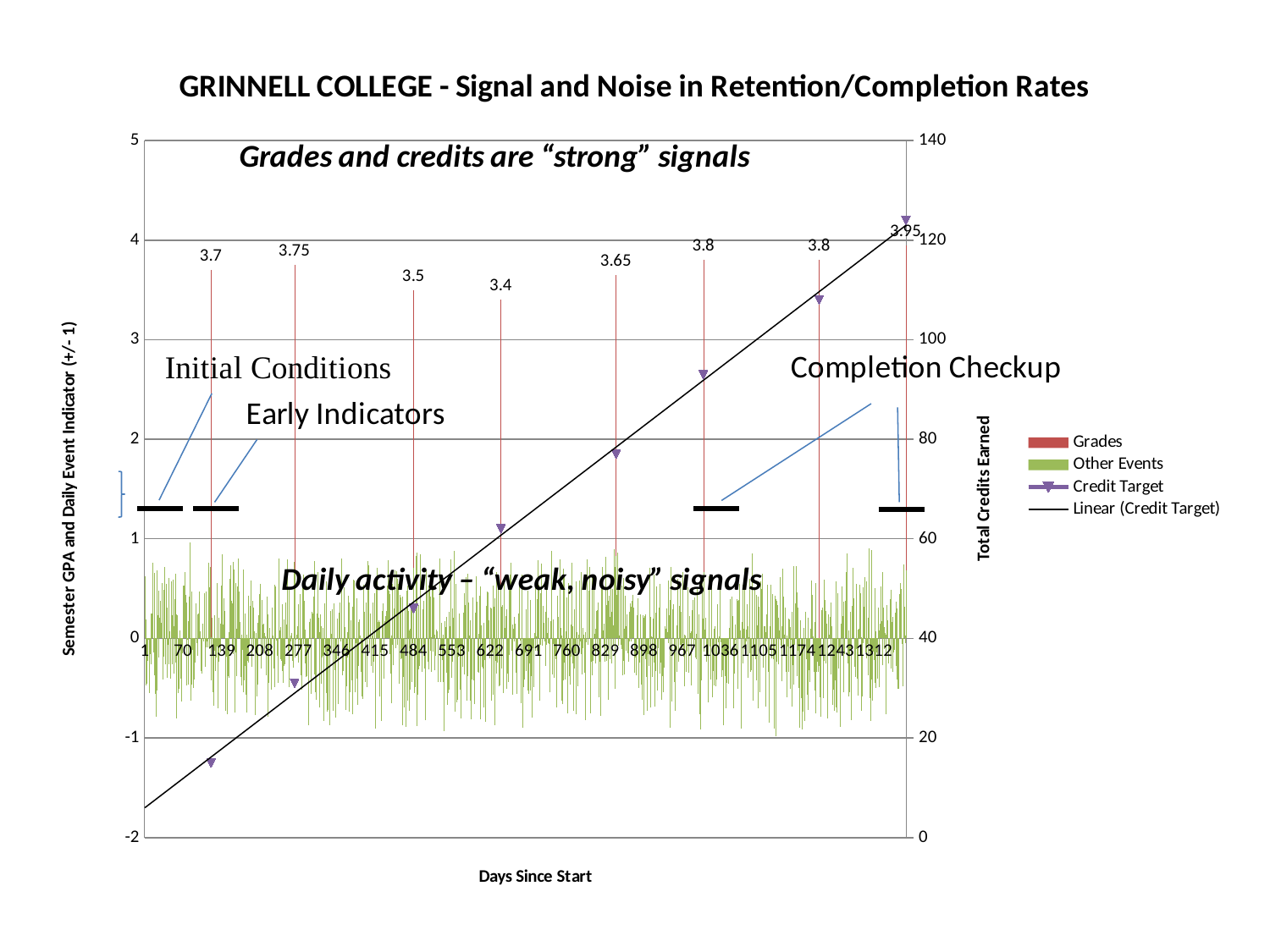
What is the difference between the highest and lowest labelled Grades values? 0.55 What is the difference between the last labelled Grades value (3.95) and the one before it (3.8)? 0.15 What is the title of the x axis? Days Since Start What is the second Grades value labelled on the chart, at day 277? 3.75 What is the lowest Grades value labelled on the chart? 3.4 How many Grades values are labelled on the chart? 8 What is the first (leftmost) Grades value labelled on the chart? 3.7 Which is larger, the first labelled Grades value (3.7) or the second (3.75)? 3.75 What is the title of the chart? GRINNELL COLLEGE - Signal and Noise in Retention/Completion Rates How many series does the legend list? 4 Does the Credit Target series rise or fall as Days Since Start increases? rises What is the highest Grades value labelled on the chart? 3.95